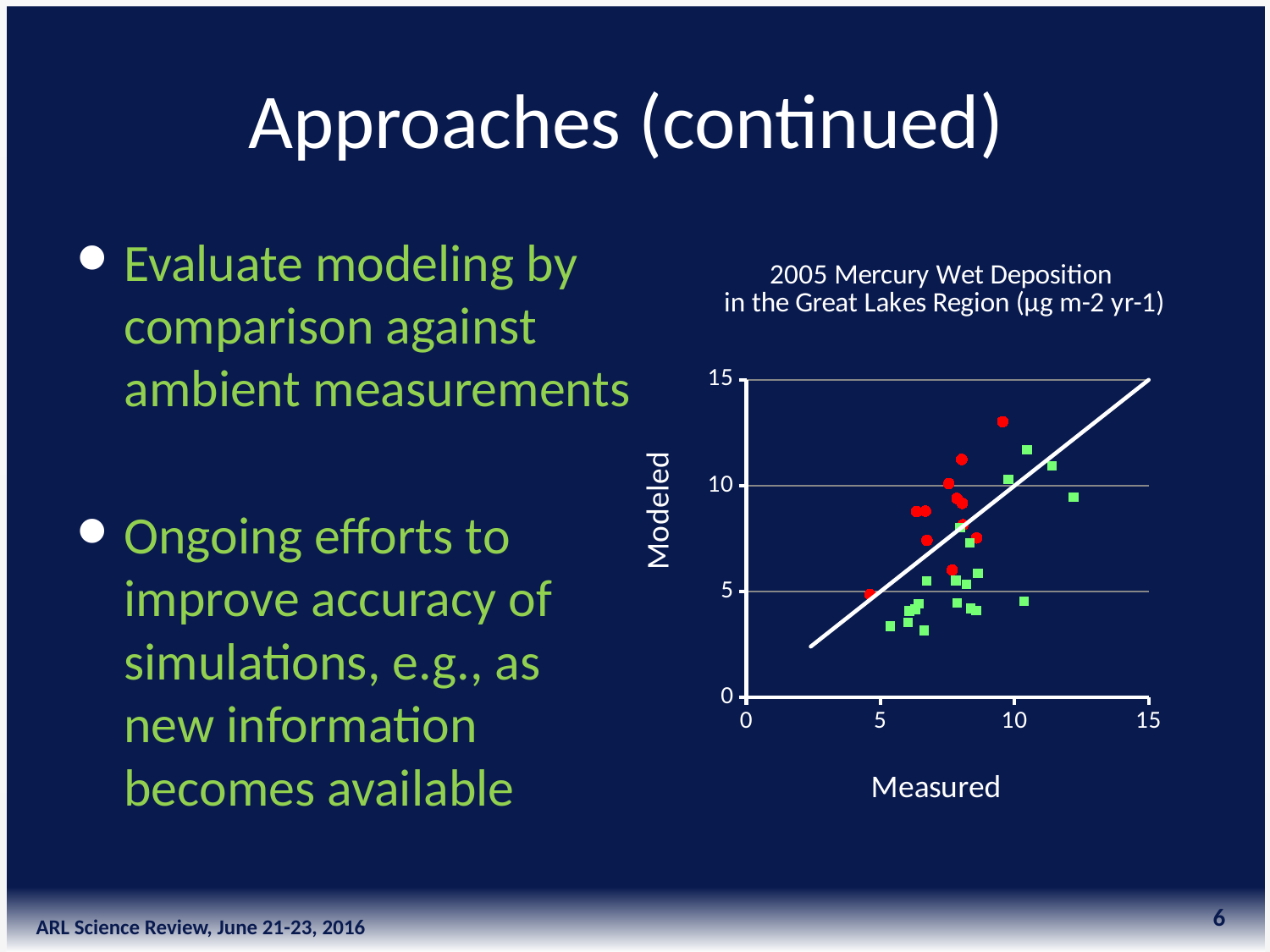
Is the smallest Measured value plotted on the chart greater or less than 5? less Is the highest Modeled value plotted on the chart greater or less than 10? greater What is the label of the horizontal axis of the chart? Measured Is the lowest Modeled value plotted on the chart greater or less than 5? less What kind of chart is shown on the slide? scatter chart What is the title of the chart on the slide? 2005 Mercury Wet Deposition in the Great Lakes Region (µg m-2 yr-1)